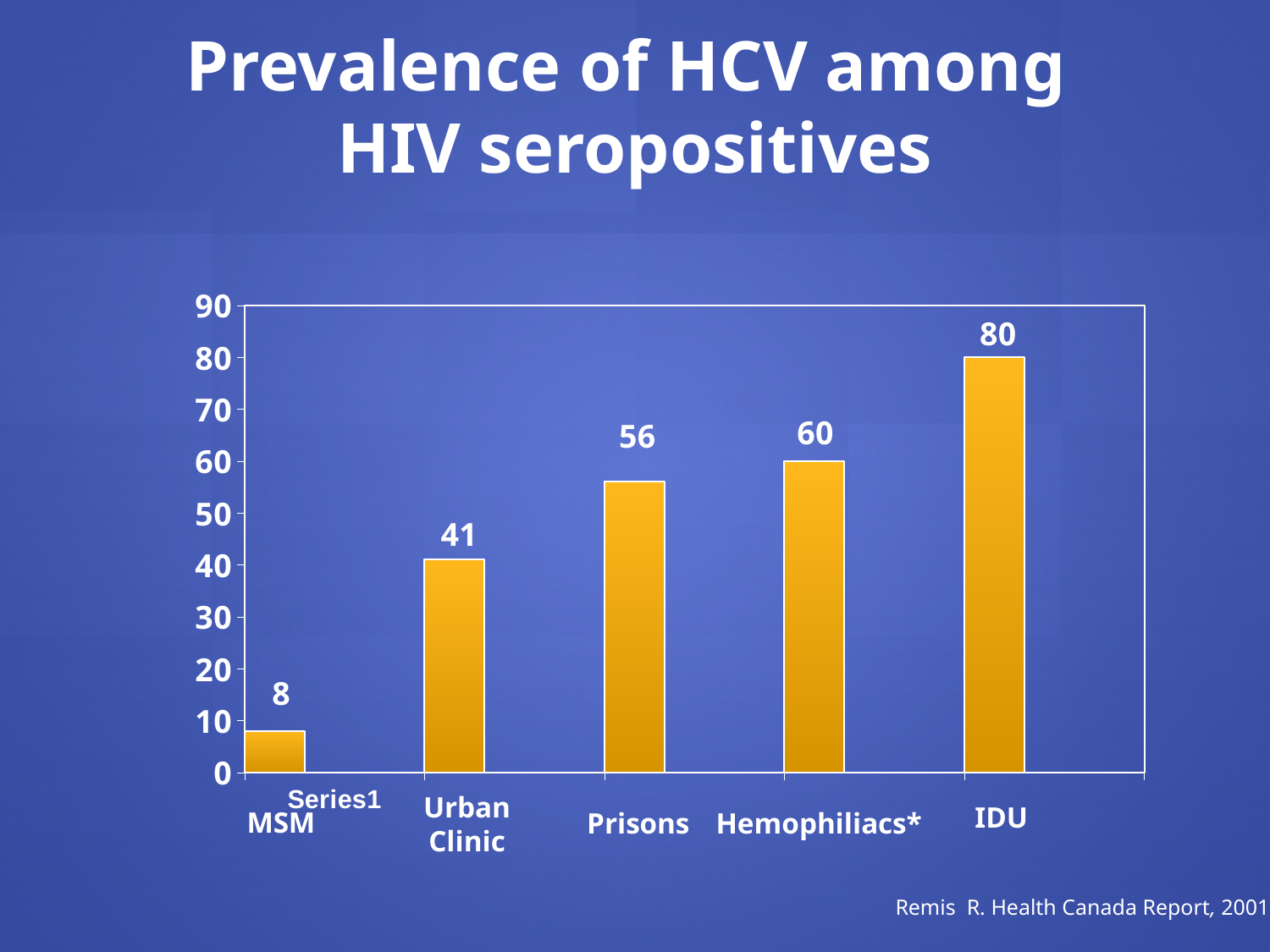
Which category has the lowest value? MSM What kind of chart is shown on the slide? Bar chart Which category has the highest value? IDU What is the value for MSM? 8 How many categories are shown on the chart? 5 What is the value for Urban Clinic? 41 Do the values rise or fall from left to right along the x axis? Rise What is the value for Prisons? 56 What is the difference between the values for Urban Clinic and MSM? 33 What is the value for IDU? 80 Which is larger, the value for Prisons or the value for Hemophiliacs*? Hemophiliacs* What is the difference between the values for IDU and Hemophiliacs*? 20